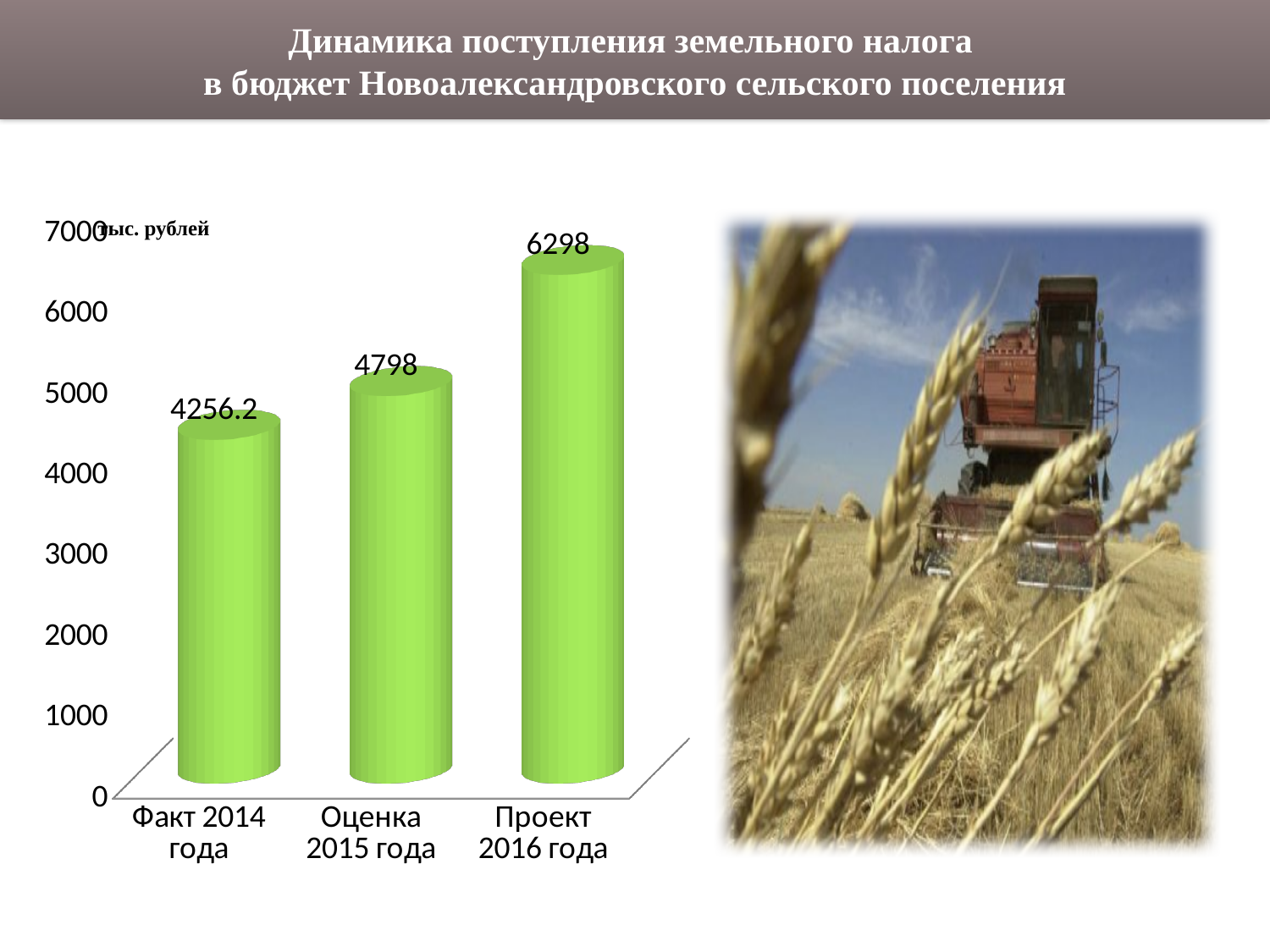
Which category has the highest value? Проект 2016 года Which category has the lowest value? Факт 2014 года What kind of chart is shown on the slide? bar chart What is the value for Факт 2014 года? 4256.2 How many categories are shown on the chart? 3 Which is larger, the value for Оценка 2015 года or the value for Факт 2014 года? Оценка 2015 года Do the values rise or fall from Факт 2014 года to Проект 2016 года? rise Is the value for Проект 2016 года greater or less than 6000? greater What is the difference between the values for Оценка 2015 года and Факт 2014 года? 541.8 What is the value for Проект 2016 года? 6298 What is the value for Оценка 2015 года? 4798 What is the difference between the values for Проект 2016 года and Оценка 2015 года? 1500